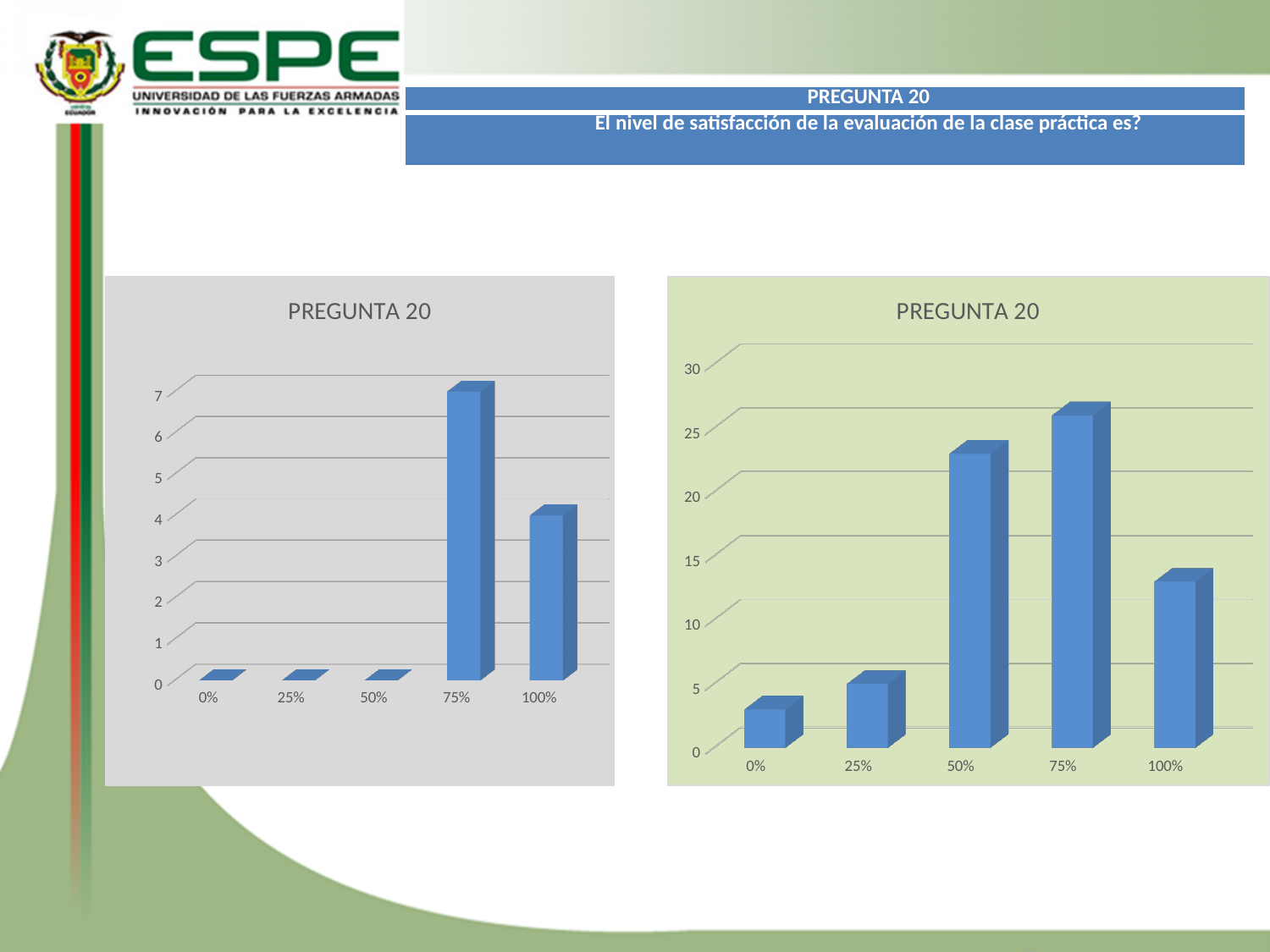
In the right chart, is the value for 50% greater or less than 20? greater In the right chart, which category has the lowest value? 0% In the left chart, which category has the highest value? 75% In the left chart, what is the value for 75%? 7 What is the title of the chart on the right? PREGUNTA 20 In the right chart, which is larger, the value for 50% or the value for 100%? 50% In the right chart, which category has the highest value? 75% In the left chart, what is the difference between the values for 75% and 100%? 3 In the left chart, what is the value for 100%? 4 In the left chart, how many categories are shown on the x axis? 5 In the right chart, is the value for 100% greater or less than 15? less What kind of chart is the chart on the right? Bar chart